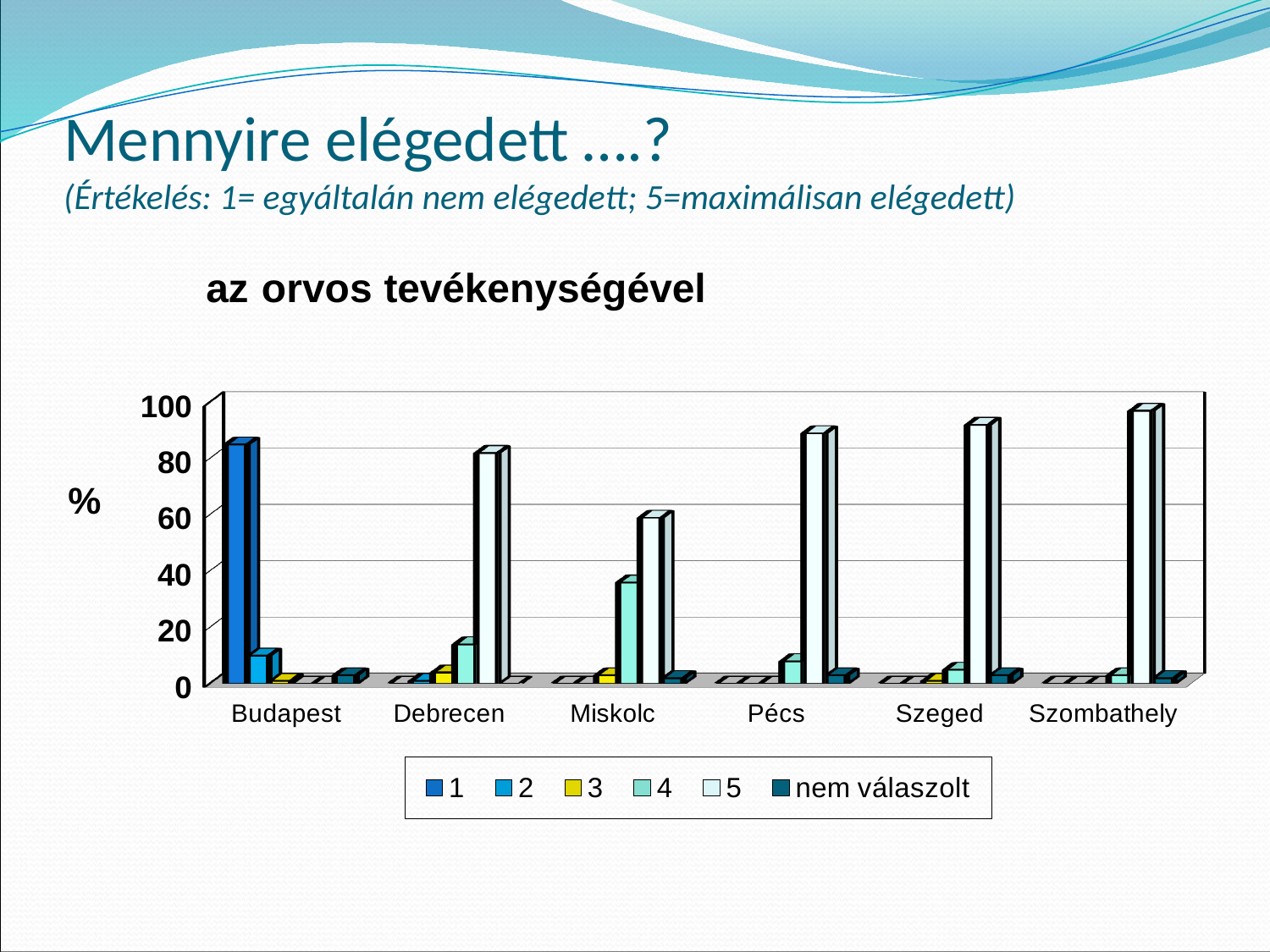
Is the value for series 4 in Miskolc greater or less than 20? greater Which city has the highest bar for series 5? Szombathely How many series does the chart's legend list? 6 What is the title of the chart? az orvos tevékenységével Is the value for series 1 in Budapest greater or less than 80? greater How many cities are shown on the x axis of the chart? 6 Is the value for series 2 in Budapest greater or less than 20? less What kind of chart is shown on the slide? bar chart What label is shown on the vertical axis of the chart? % In Miskolc, which is larger: the value for series 4 or the value for series 5? 5